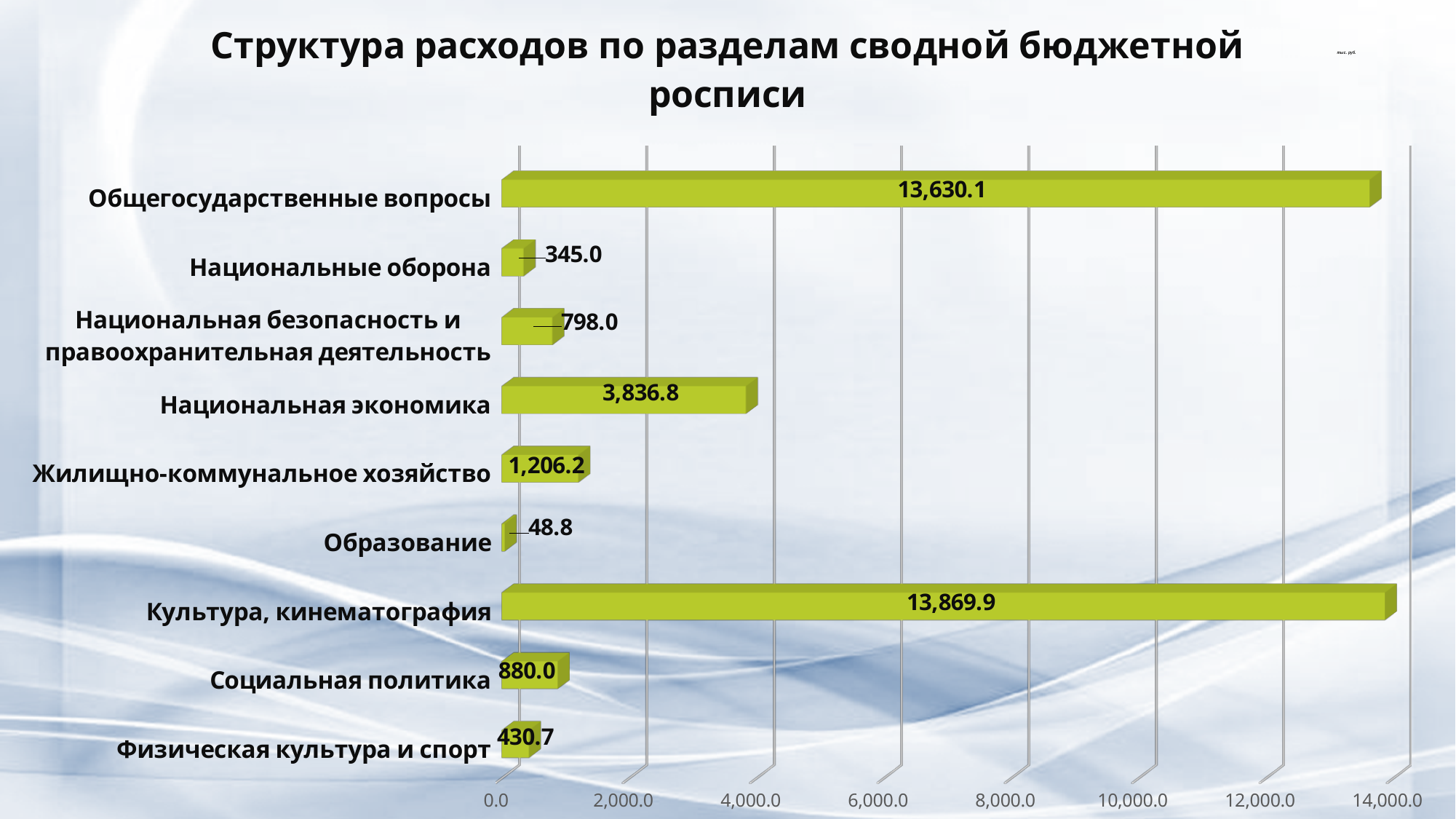
What is the value for Национальная экономика? 3,836.8 Which is larger, the value for Национальная безопасность и правоохранительная деятельность or the value for Национальные оборона? Национальная безопасность и правоохранительная деятельность Is the value for Национальная экономика greater or less than 4,000.0? less What is the value for Культура, кинематография? 13,869.9 What is the difference between the values for Культура, кинематография and Общегосударственные вопросы? 239.8 Which category has the lowest value? Образование What is the value for Жилищно-коммунальное хозяйство? 1,206.2 Which category has the highest value? Культура, кинематография How many categories are shown in the chart? 9 What is the value for Социальная политика? 880.0 What kind of chart is shown on the slide? bar chart What is the difference between the values for Национальная экономика and Жилищно-коммунальное хозяйство? 2,630.6